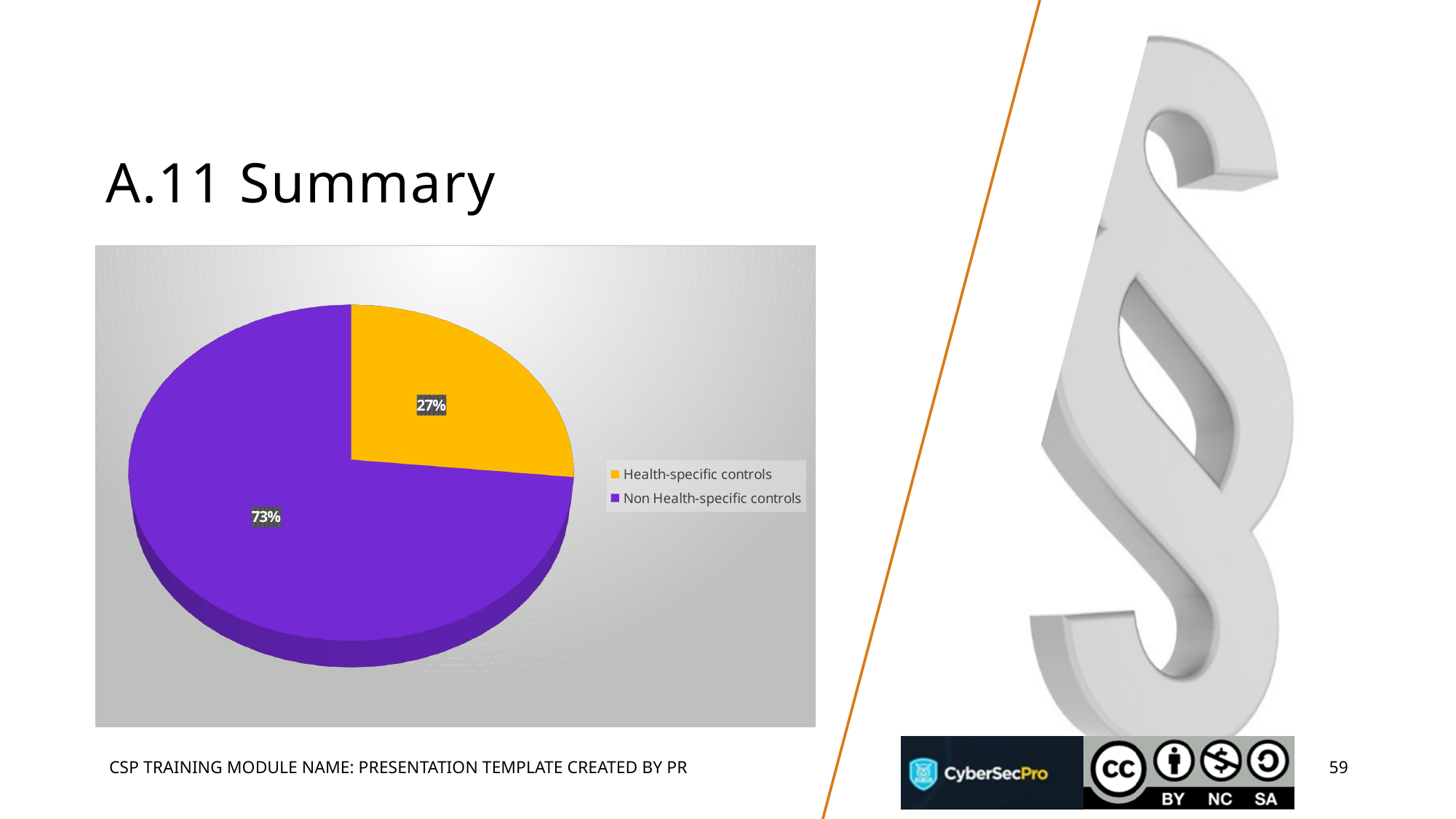
How many entries does the legend list? 2 What colour is the slice for Health-specific controls? orange What share of the pie is Health-specific controls? 27% What is the difference in percentage points between Non Health-specific controls and Health-specific controls? 46 What colour is the slice for Non Health-specific controls? purple Which category has the smallest slice of the pie? Health-specific controls Which is larger, the share for Health-specific controls or the share for Non Health-specific controls? Non Health-specific controls How many slices does the pie chart have? 2 What share of the pie is Non Health-specific controls? 73% Which category has the largest slice of the pie? Non Health-specific controls What kind of chart is shown on the slide? pie chart